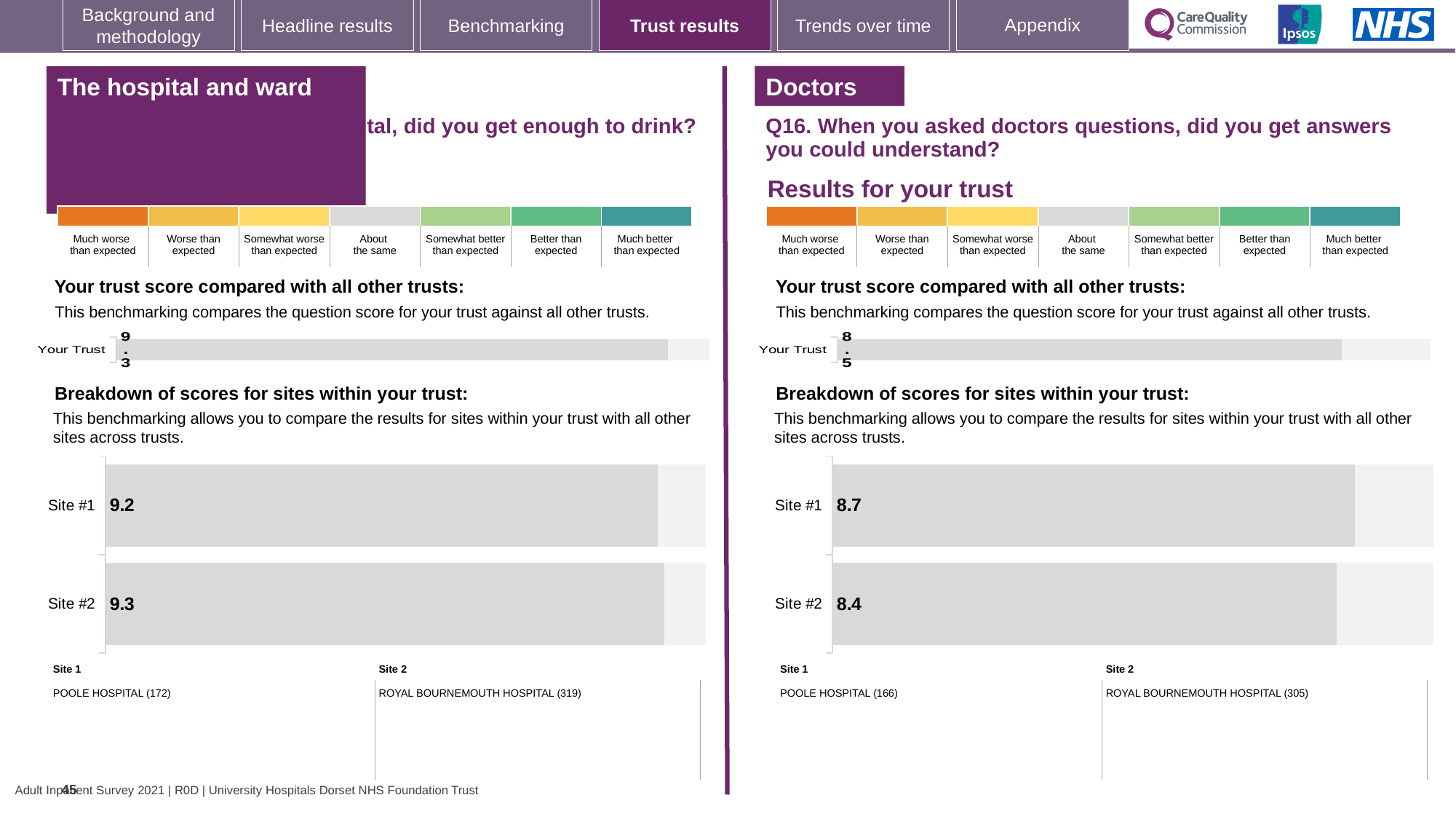
On the right-hand 'Your trust score compared with all other trusts' chart for Q16, what is the score shown for Your Trust? 8.5 On the left-hand chart (breakdown of scores for sites), which site has the lower score? Site #1 On the right-hand chart for Q16 (breakdown of scores for sites), which site has the higher score? Site #1 On the left-hand chart (breakdown of scores for sites within your trust), what is the score for Site #1? 9.2 On the right-hand chart for Q16 (breakdown of scores for sites), what is the difference between the Site #1 and Site #2 scores? 0.3 On the left-hand chart (breakdown of scores for sites within your trust), what is the score for Site #2? 9.3 On the right-hand chart for Q16 (breakdown of scores for sites within your trust), what is the score for Site #2? 8.4 How many sites are shown on the right-hand chart for Q16 (breakdown of scores for sites within your trust)? 2 What kind of chart is used for the breakdown of scores for sites within your trust on the left-hand side? Bar chart On the right-hand chart for Q16 (breakdown of scores for sites within your trust), what is the score for Site #1? 8.7 On the left-hand 'Your trust score compared with all other trusts' chart, what is the score shown for Your Trust? 9.3 On the left-hand chart (breakdown of scores for sites), what is the difference between the Site #2 and Site #1 scores? 0.1